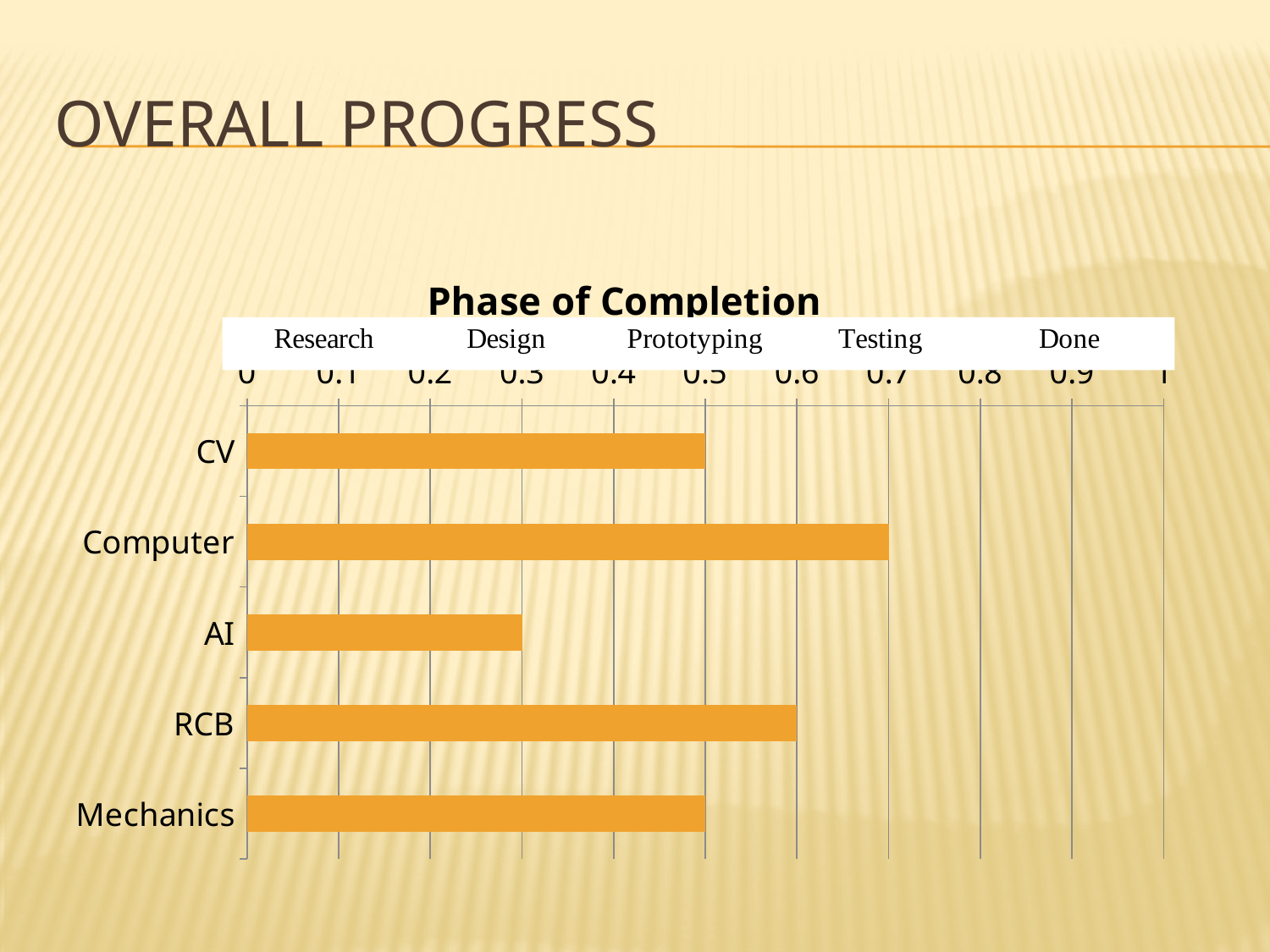
What is the value for RCB? 0.6 What is the title of the chart? Phase of Completion What is the value for AI? 0.3 Is the value for Mechanics greater or less than 0.8? less How many categories are plotted in the chart? 5 What kind of chart is shown on the slide? bar chart What is the value for CV? 0.5 What is the value for Computer? 0.7 What is the difference between the values for Computer and AI? 0.4 Which is larger, the value for RCB or the value for Mechanics? RCB Which category has the lowest value? AI Which category has the highest value? Computer